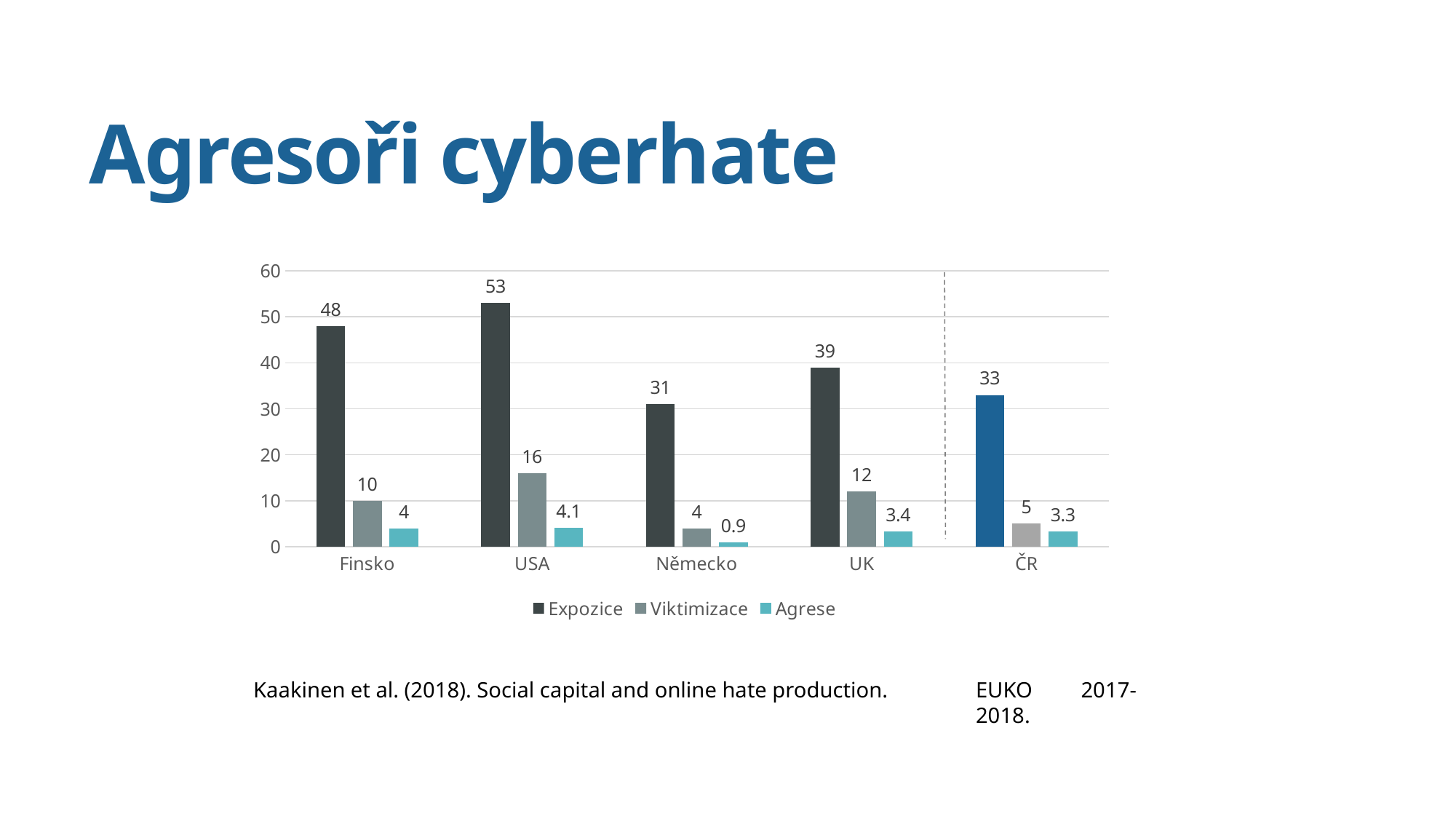
What is the Agrese value for ČR? 3.3 How many series does the legend list? 3 What is the difference between the Expozice values for USA and Finsko? 5 What is the Agrese value for Německo? 0.9 Which country has the lowest Agrese value? Německo How many countries are shown on the x axis? 5 What is the Viktimizace value for UK? 12 Which country has the highest Expozice value? USA What is the Expozice value for USA? 53 What are the three series named in the legend? Expozice, Viktimizace, Agrese Which is larger, the Viktimizace value for Finsko or for UK? UK What kind of chart is shown on the slide? Bar chart